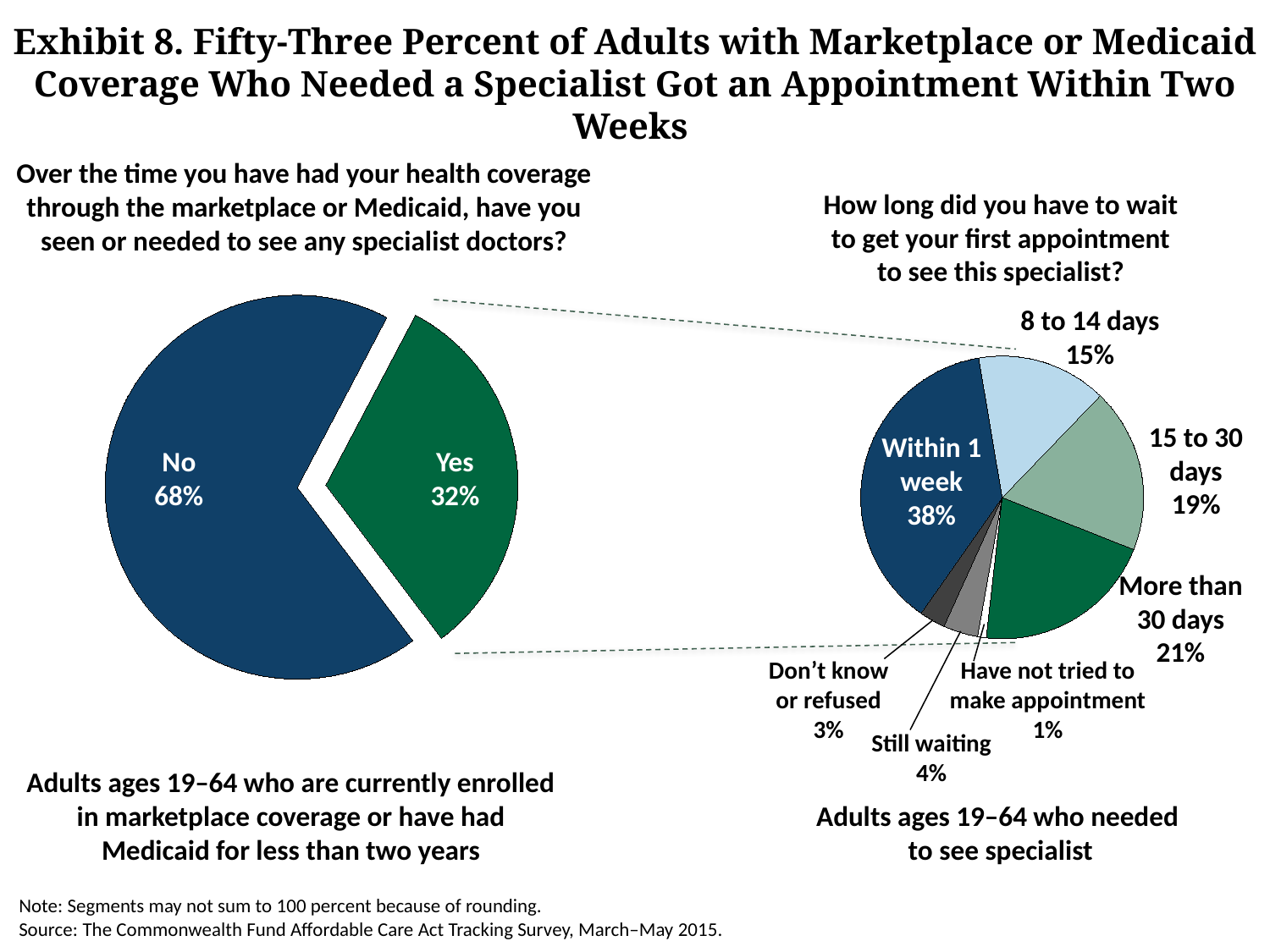
In the right pie chart, which wait-time category has the largest share? Within 1 week In the right pie chart, what is the difference in percentage points between "15 to 30 days" and "8 to 14 days"? 4 In the right pie chart, what percentage waited "More than 30 days"? 21% In the left pie chart, what percentage of adults answered "No" to having seen or needed to see a specialist? 68% In the left pie chart, what is the difference in percentage points between "No" and "Yes"? 36 In the right pie chart, what percentage of adults are "Still waiting"? 4% In the right pie chart, which category has the smallest share? Have not tried to make appointment In the right pie chart, what share of adults waited "Within 1 week" for their first specialist appointment? 38% How many categories are shown in the right pie chart? 7 What type of chart is used on the left side of the slide? Pie chart In the left pie chart, what percentage of adults answered "Yes"? 32% In the right pie chart, which is larger: "More than 30 days" or "15 to 30 days"? More than 30 days